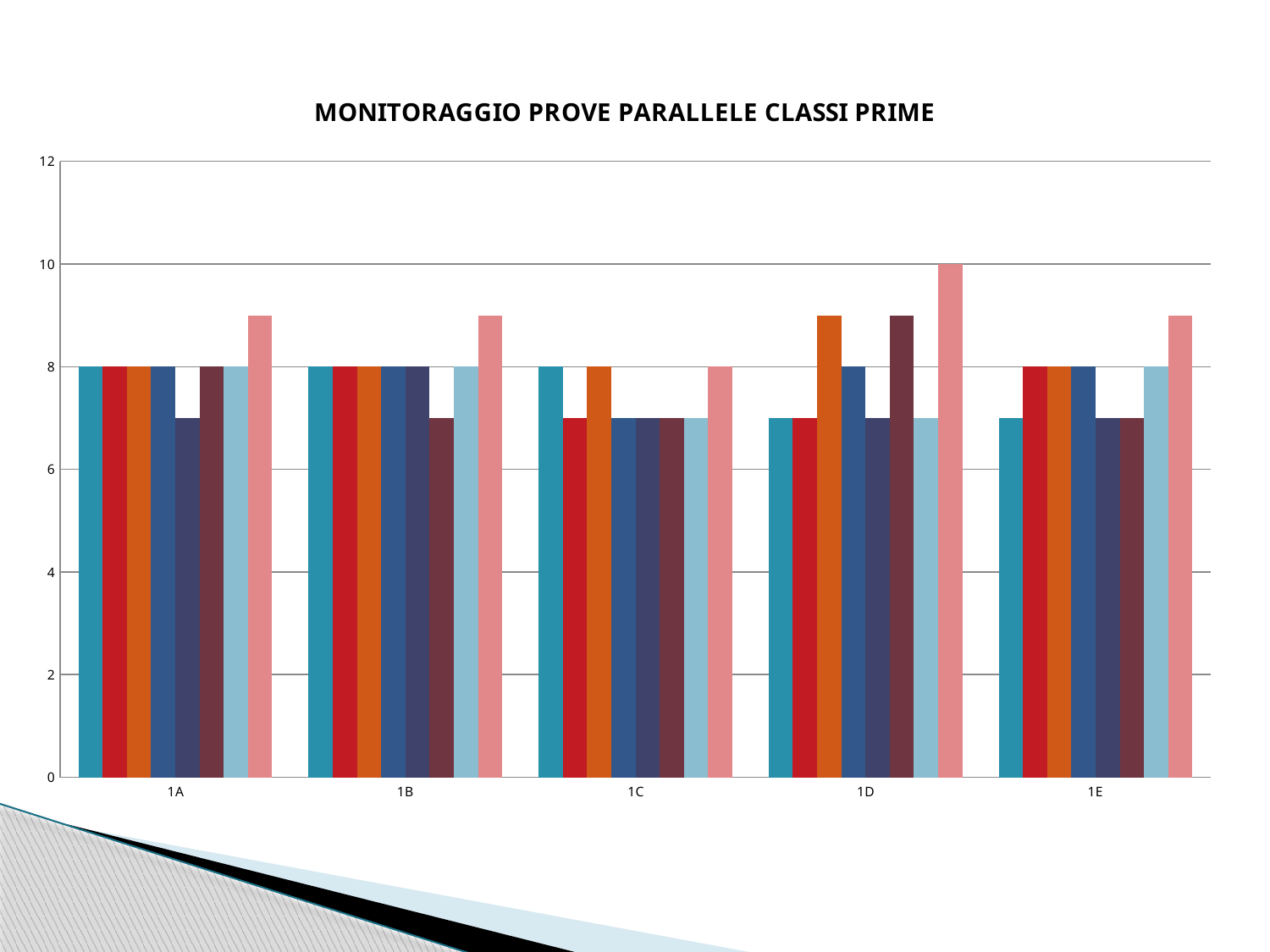
What value does the leftmost (teal) bar in category 1C reach? 8 What is the title of the chart? MONITORAGGIO PROVE PARALLELE CLASSI PRIME What is the maximum value shown on the y axis? 12 What kind of chart is shown on the slide? bar chart What value does the tallest bar in the chart reach? 10 Is the tallest bar in category 1D greater or less than 8? greater Is the rightmost (pink) bar in category 1C greater or less than 10? less How many categories are shown on the x axis? 5 Which category contains the tallest bar in the chart? 1D How many bars are plotted for each category? 8